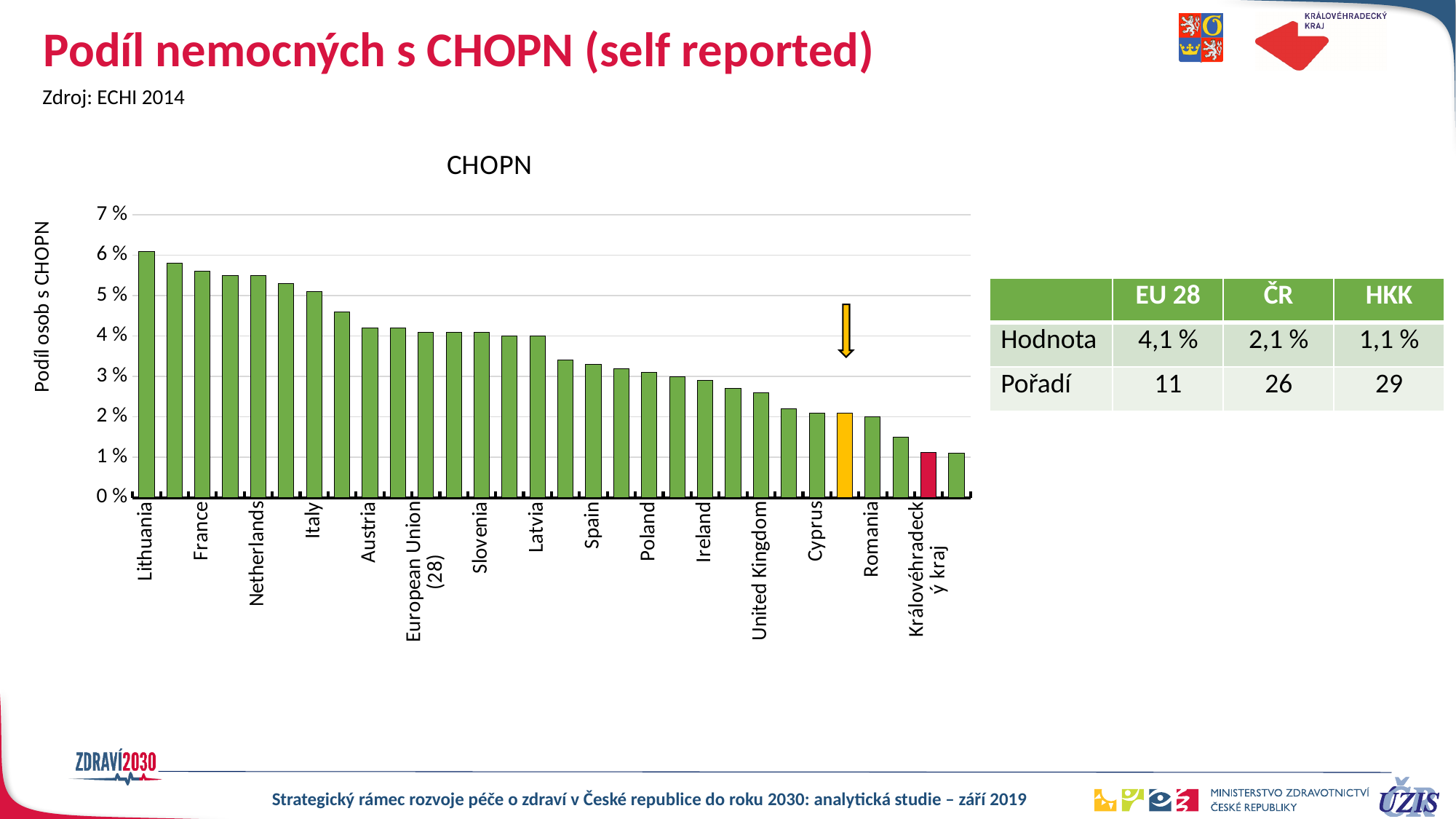
What is the difference between the EU 28 value and the HKK value? 3,0 % Is the value for Spain greater or less than 4 %? less What is the title of the y axis of the chart? Podíl osob s CHOPN What is the value for ČR, shown as the yellow bar? 2,1 % What is the value for Královéhradecký kraj (HKK) in the chart? 1,1 % What kind of chart is shown on the slide? bar chart Which country has the highest share of people with CHOPN in the chart? Lithuania Do the bar values rise or fall from left to right along the x axis? fall Which has a higher value, Netherlands or Ireland? Netherlands Is the value for France greater or less than 5 %? greater What is the value for European Union (28) in the chart? 4,1 % Which has a higher value, Lithuania or Romania? Lithuania